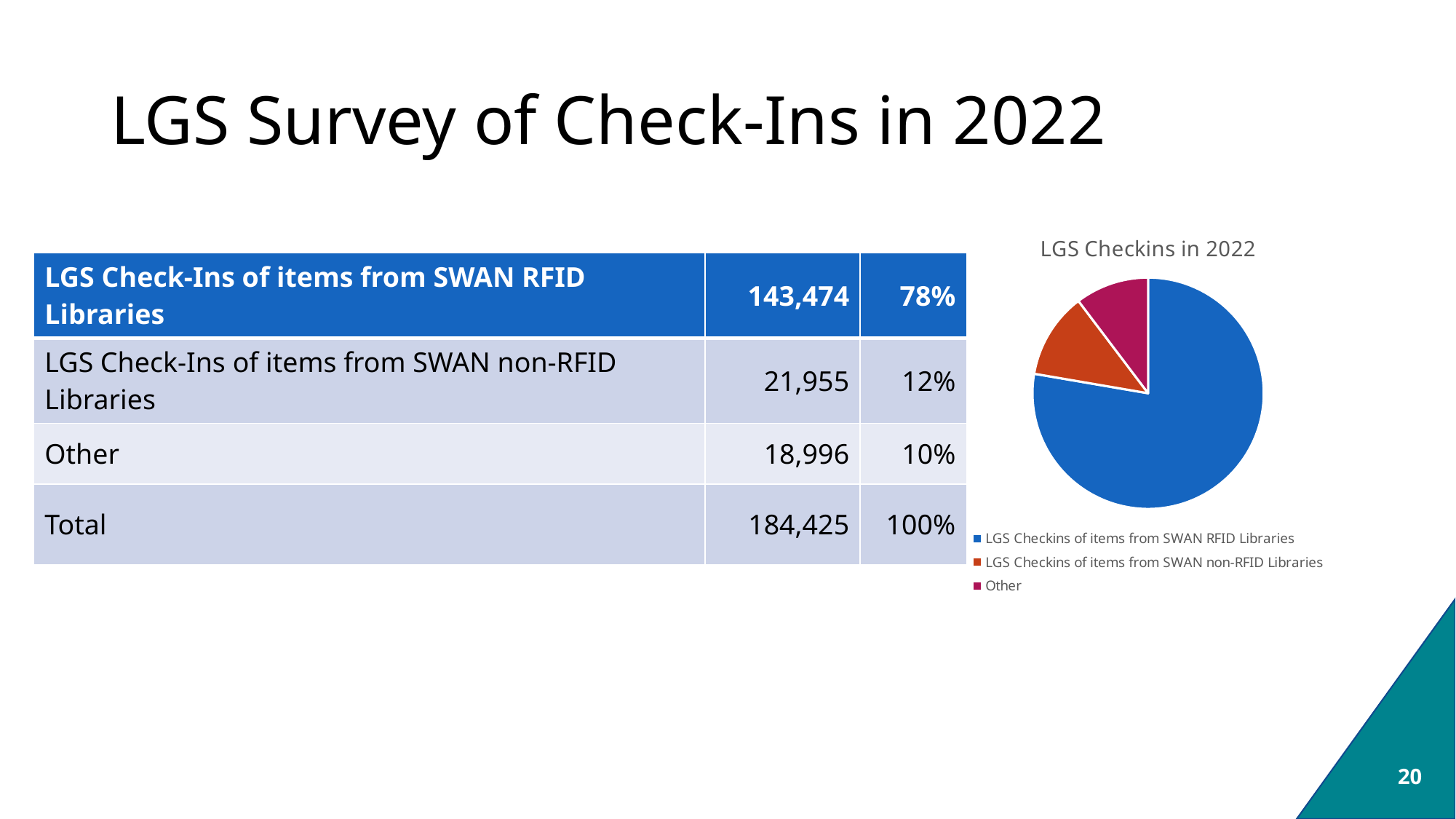
How many slices does the pie chart have? 3 According to the table, what share of check-ins falls in the Other category? 10% Which category has the smallest slice of the pie chart? Other How many entries does the pie chart's legend list? 3 What kind of chart is shown on the slide? pie chart Which category has the largest slice of the pie chart? LGS Checkins of items from SWAN RFID Libraries What is the title of the pie chart? LGS Checkins in 2022 Which slice is larger: SWAN non-RFID Libraries or Other? SWAN non-RFID Libraries What share of the pie does the SWAN RFID Libraries slice represent, per the table? 78% According to the table, how many LGS check-ins were of items from SWAN RFID Libraries? 143,474 According to the table, how many LGS check-ins were of items from SWAN non-RFID Libraries? 21,955 What is the total number of check-ins shown in the table? 184,425